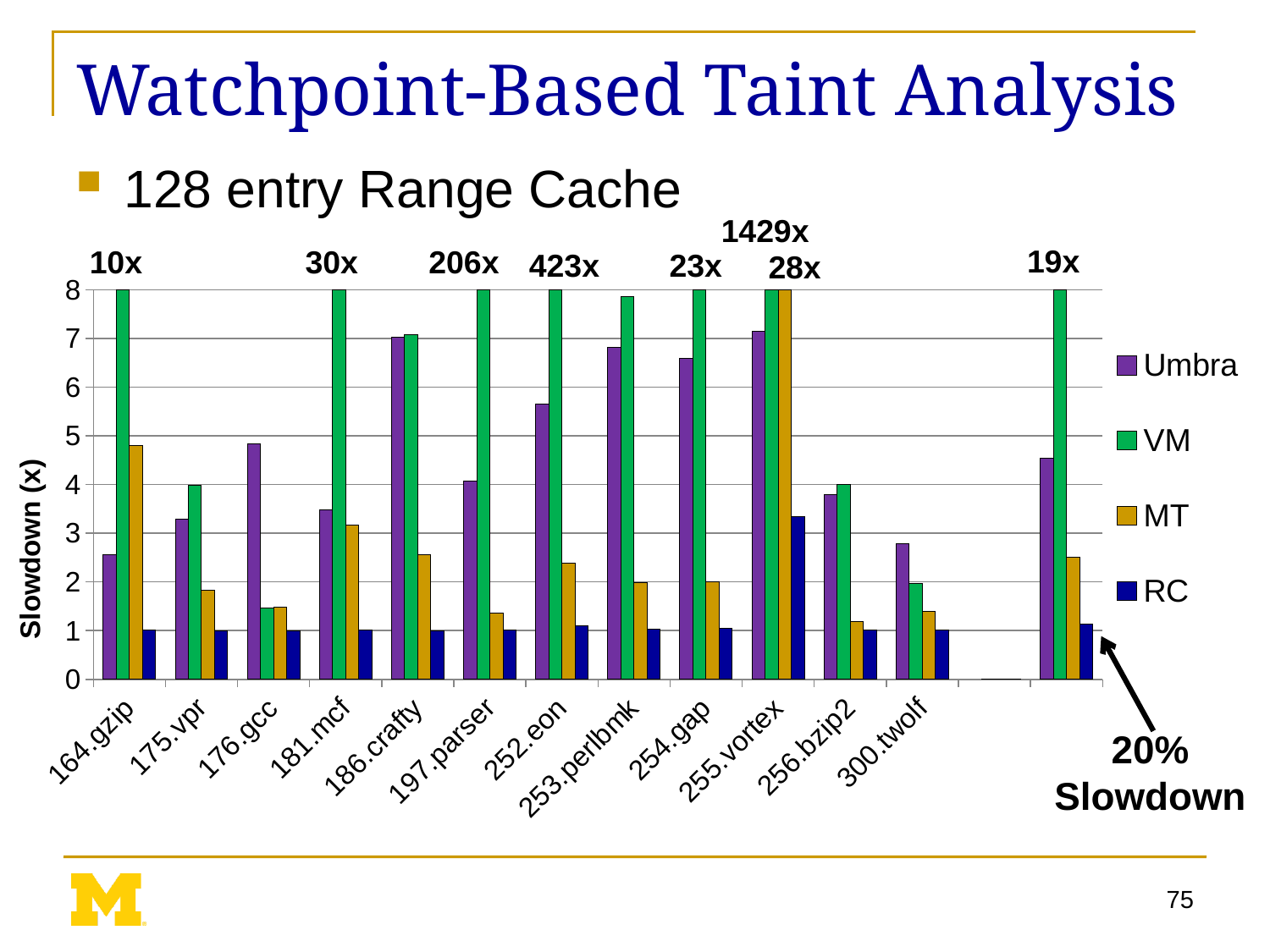
What slowdown value is annotated above the VM bar for 252.eon? 423x What kind of chart is shown on the slide? bar chart Is the Umbra value for 176.gcc greater or less than 4? greater For 300.twolf, which is larger, the Umbra value or the VM value? Umbra Which series has the highest value for 176.gcc? Umbra What slowdown value is annotated above the VM bar for 197.parser? 206x Is the VM value for 176.gcc greater or less than 2? less What is the label of the y axis? Slowdown (x) Which series has the lowest value for 164.gzip? RC How many series does the legend list? 4 Is the RC value for 255.vortex greater or less than 3? greater How many labeled benchmark categories are on the x axis? 12